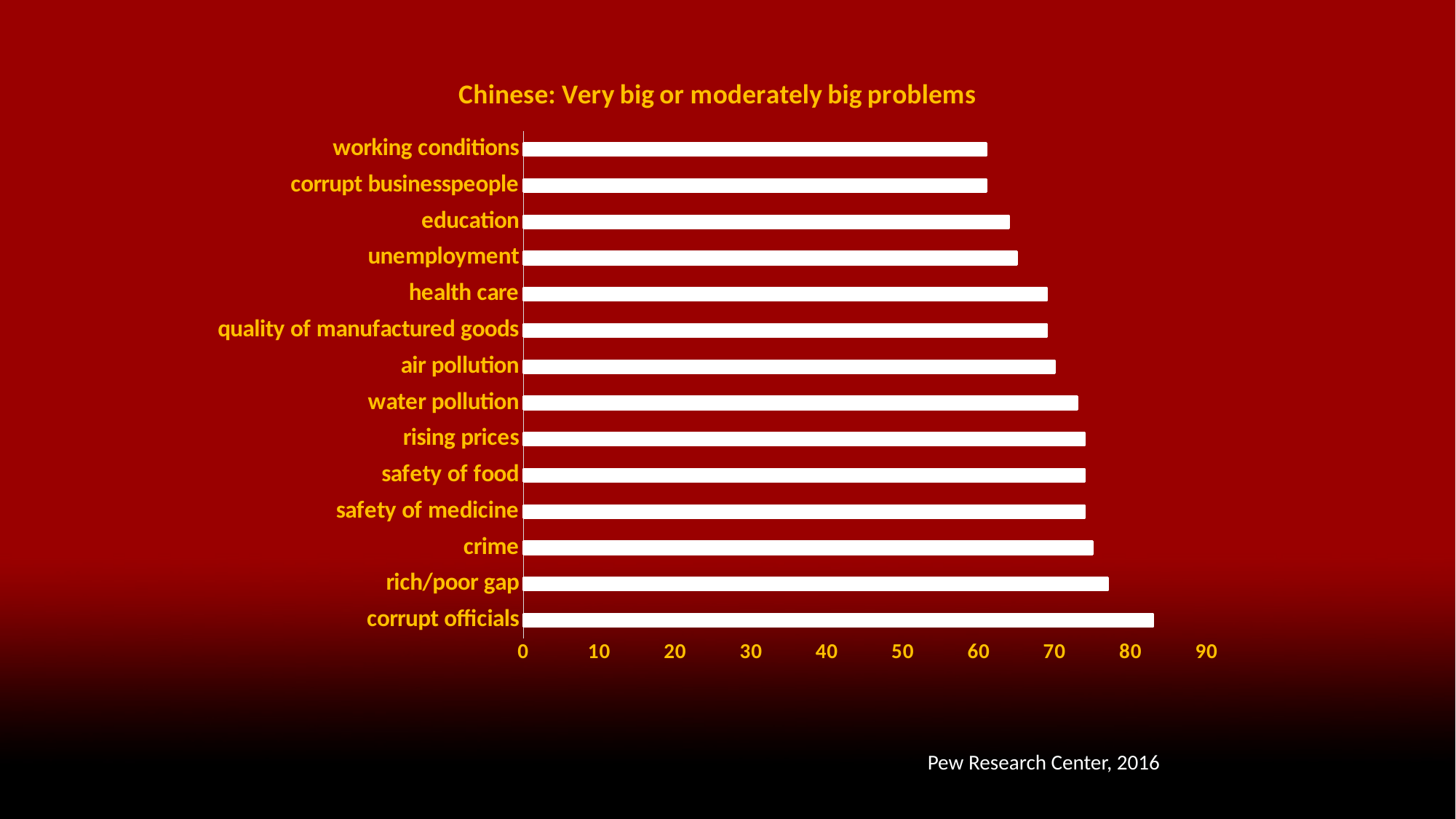
Which is larger, the value for education or the value for water pollution? water pollution What kind of chart is shown on the slide? bar chart Is the value for rich/poor gap greater or less than 80? less Is the value for crime greater or less than 70? greater Is the value for corrupt officials greater or less than 80? greater Which problem has the highest value in the chart? corrupt officials Which is larger, the value for corrupt officials or the value for rich/poor gap? corrupt officials What is the title of the chart? Chinese: Very big or moderately big problems How many categories (problems) are plotted in the chart? 14 What source is cited for the chart data? Pew Research Center, 2016